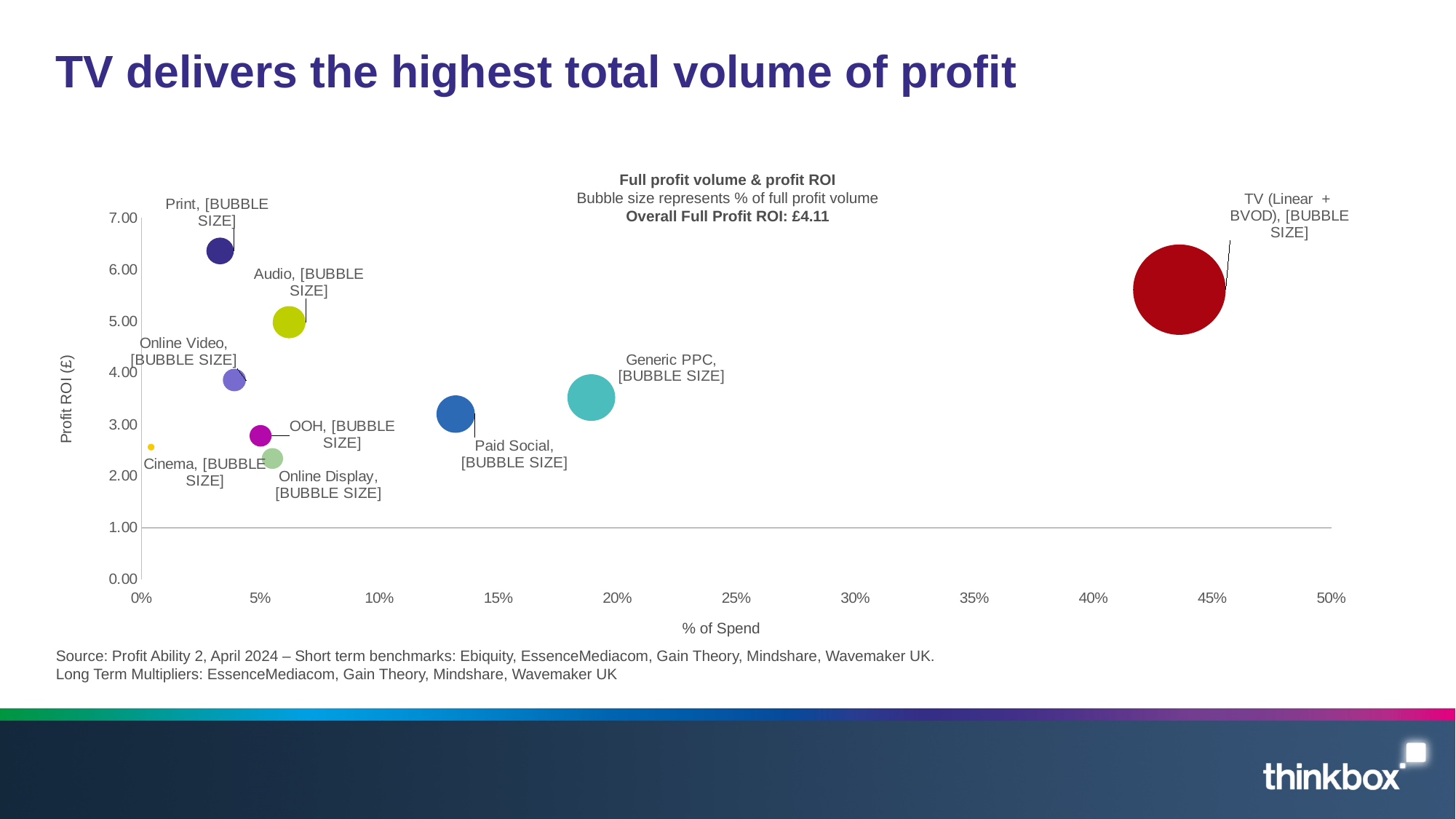
Which has the higher Profit ROI, Print or Audio? Print Which has the higher % of Spend, Generic PPC or Paid Social? Generic PPC How many media channels (bubbles) are plotted on the chart? 9 Is the Profit ROI for Print greater or less than 6.00? greater Which channel has the lowest % of Spend? Cinema Which channel has the highest Profit ROI? Print Is the Profit ROI for Online Display greater or less than 3.00? less What kind of chart is shown on the slide? Bubble chart Is the % of Spend for Paid Social greater or less than 10%? greater What is the Overall Full Profit ROI stated on the chart? £4.11 Which channel has the highest % of Spend? TV (Linear + BVOD)